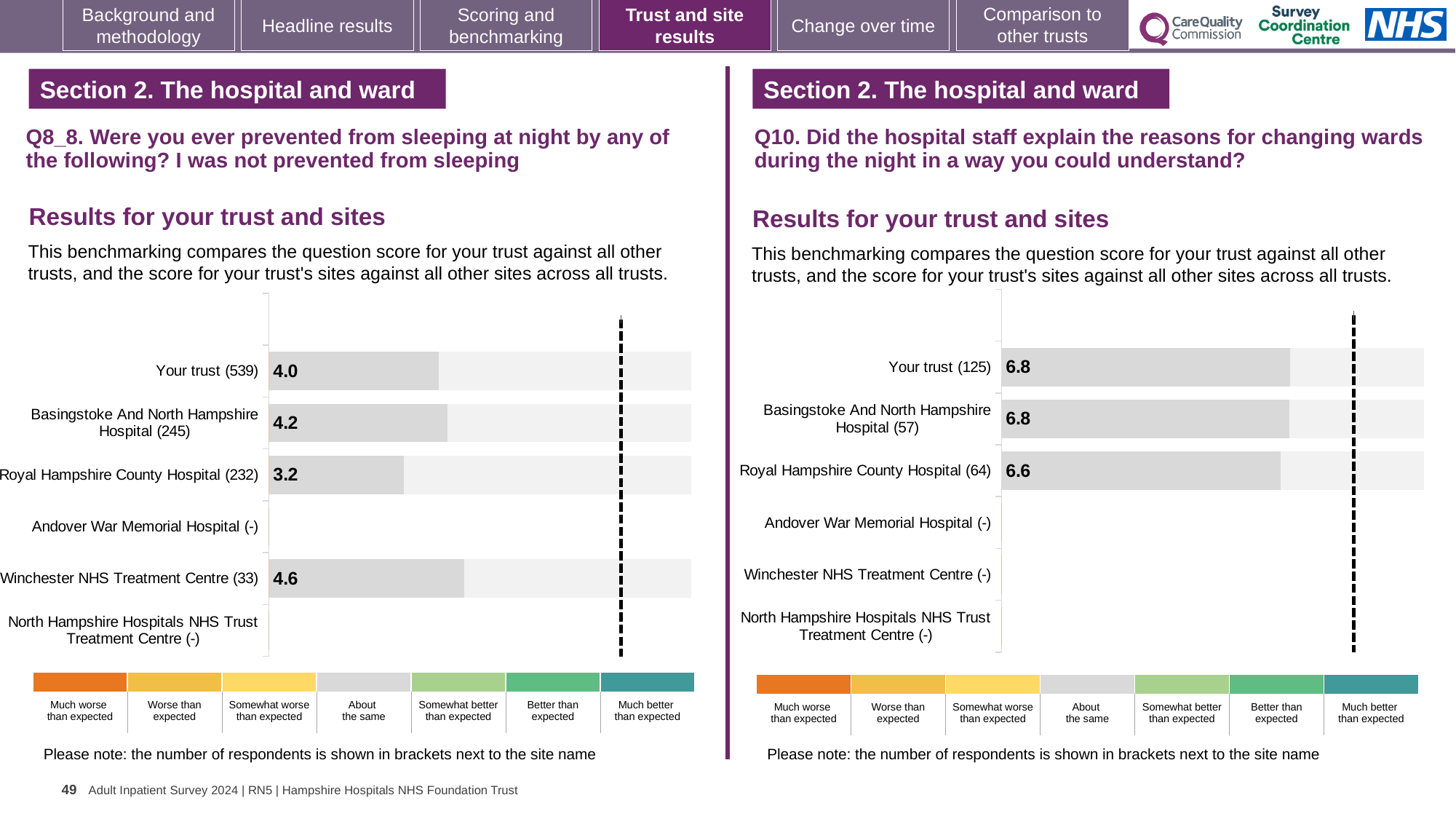
In the Q8_8 chart on the left, which site has the highest score? Winchester NHS Treatment Centre In the Q10 chart on the right, what is the difference between the scores for Your trust and Royal Hampshire County Hospital? 0.2 In the Q8_8 chart on the left, which has the higher score: Basingstoke And North Hampshire Hospital or Your trust? Basingstoke And North Hampshire Hospital In the Q8_8 chart on the left, what is the score for Your trust? 4.0 In the Q10 chart on the right, what is the score for Royal Hampshire County Hospital? 6.6 In the Q8_8 chart on the left, what is the difference between the scores for Winchester NHS Treatment Centre and Royal Hampshire County Hospital? 1.4 What type of chart is used in the Q8_8 chart on the left? Bar chart In the Q8_8 chart on the left, what is the score for Royal Hampshire County Hospital? 3.2 In the Q8_8 chart on the left, which site has the lowest plotted score? Royal Hampshire County Hospital In the Q10 chart on the right, what is the score for Basingstoke And North Hampshire Hospital? 6.8 In the Q10 chart on the right, which site has the lowest plotted score? Royal Hampshire County Hospital In the Q8_8 chart on the left, how many sites or trust rows are listed on the axis? 6